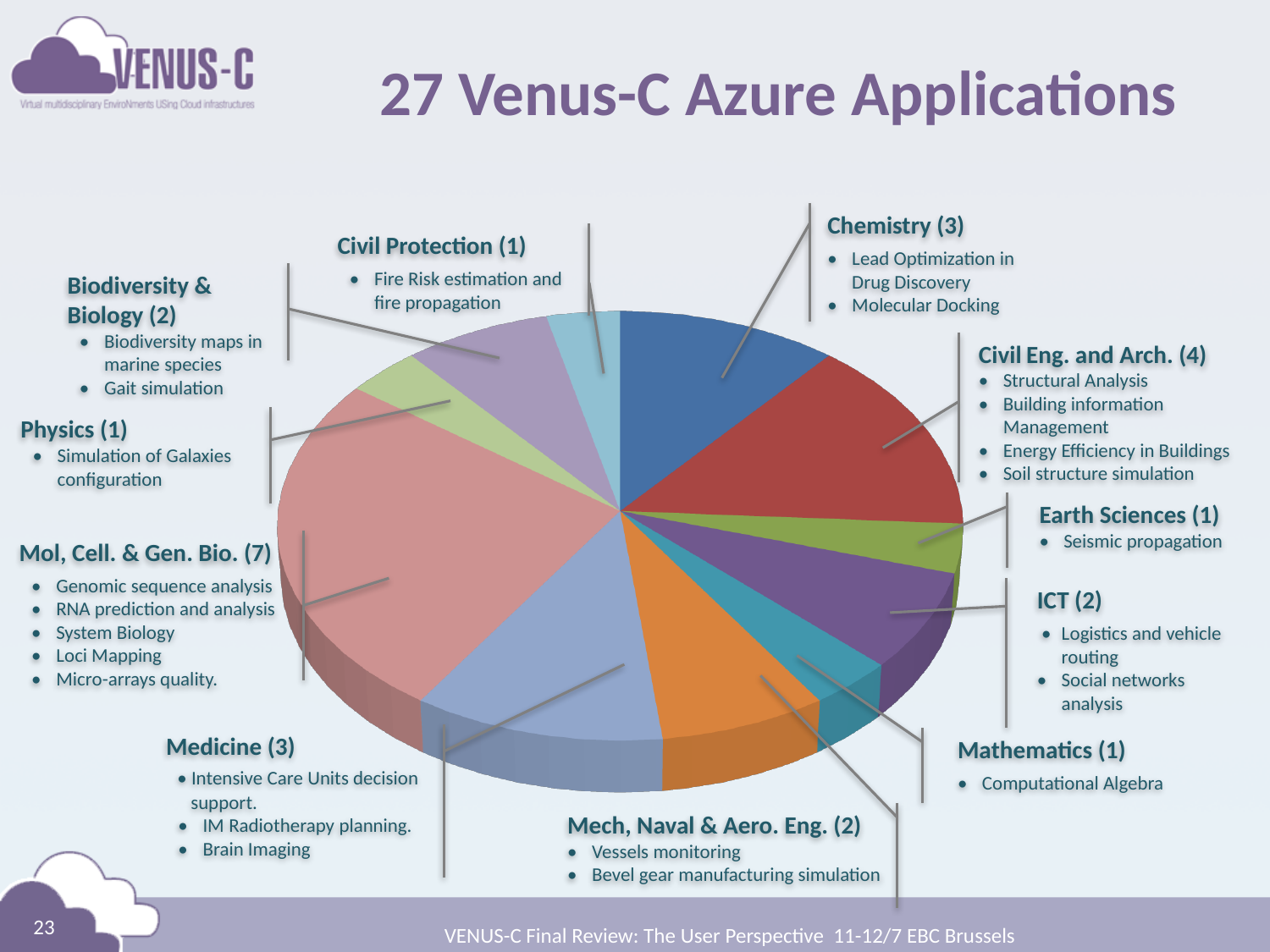
What is the difference between the number of applications in Mol, Cell. & Gen. Bio. and in Civil Eng. and Arch.? 3 How many categories have exactly 1 application? 4 How many applications are in the Mol, Cell. & Gen. Bio. category? 7 How many categories are shown in the pie chart? 11 Which has more applications, Medicine or Mathematics? Medicine How many applications are in the Civil Eng. and Arch. category? 4 What is the total number of applications across all categories? 27 How many applications are in the Chemistry category? 3 Which category has the largest number of applications? Mol, Cell. & Gen. Bio. How many applications are in the ICT category? 2 What is the title of the slide? 27 Venus-C Azure Applications What kind of chart is shown on the slide? pie chart